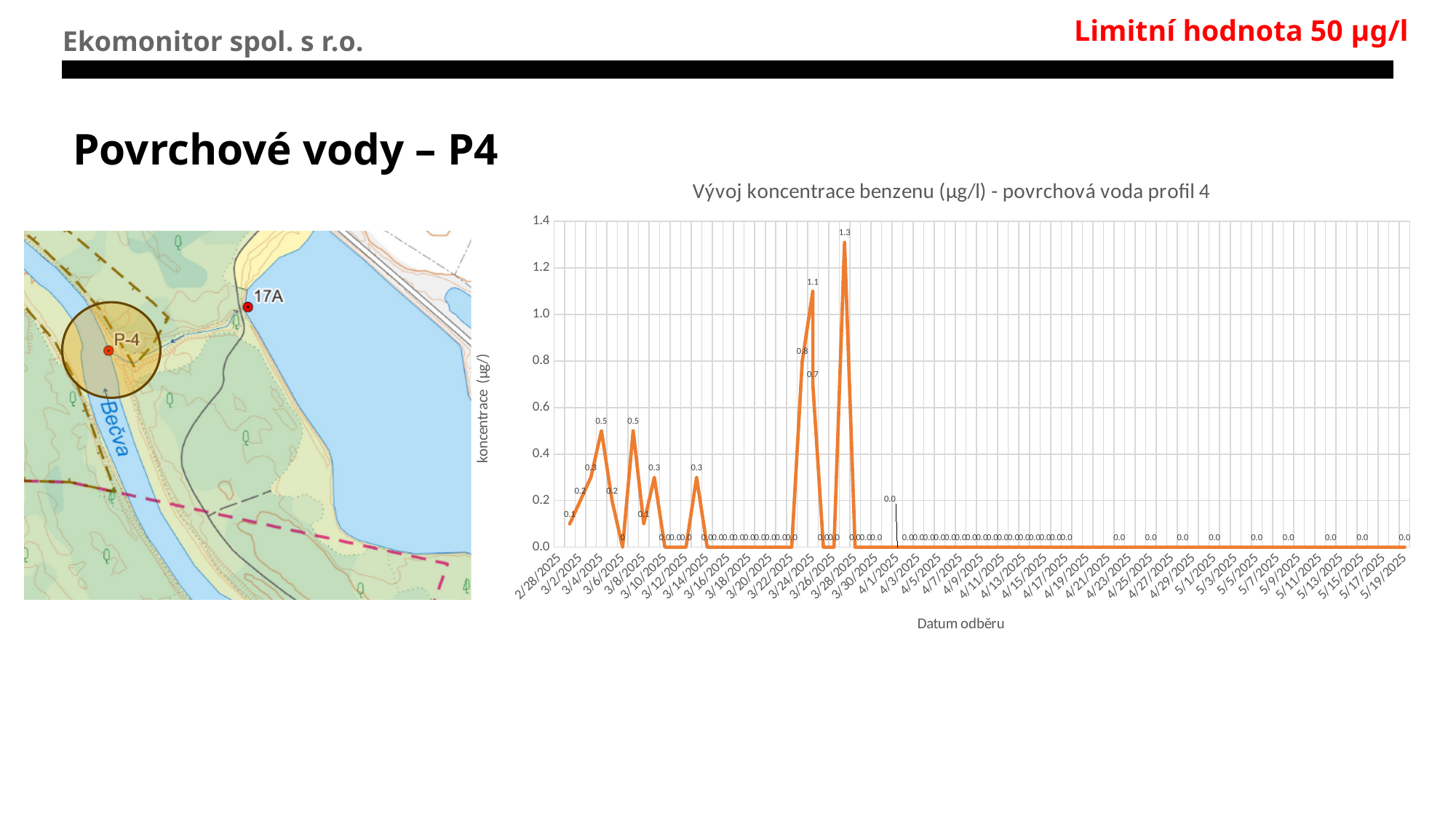
Which is larger, the peak labelled 1.3 or the peak labelled 1.1? 1.3 Is the value on 5/19/2025 greater or less than 0.2? less Is the highest peak of the line greater or less than 1.0? greater Do the values rise or fall between 2/28/2025 and 3/4/2025? rise What is the highest labelled concentration value in the chart? 1.3 What kind of chart is shown on the slide? line chart What is the title of the chart? Vývoj koncentrace benzenu (µg/l) - povrchová voda profil 4 What is the highest tick value shown on the y axis? 1.4 What is the lowest labelled concentration value in the chart? 0.0 What is the label of the x axis of the chart? Datum odběru